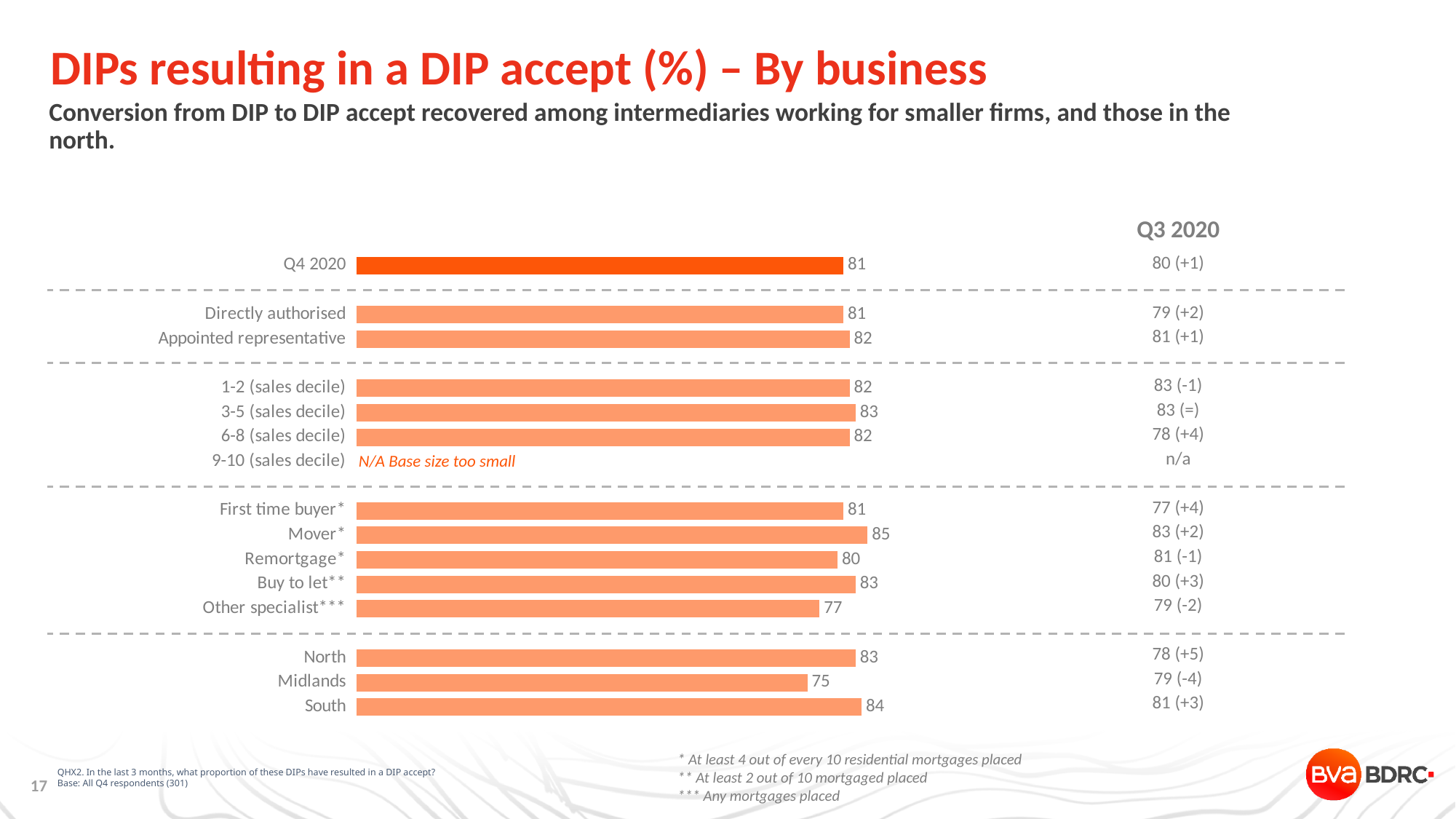
What is the value for the Q4 2020 bar at the top of the chart? 81 What is the difference between the values for Mover and Remortgage? 5 What is the value for Other specialist? 77 What is the value for Midlands? 75 Which category is marked 'N/A Base size too small' instead of a bar? 9-10 (sales decile) Which is larger, the value for North or the value for Midlands? North Which category has the highest value in the chart? Mover How many bars are plotted in the chart? 14 What is the difference between the values for South and Midlands? 9 What kind of chart is shown on the slide? Bar chart Which category has the lowest value in the chart? Midlands What is the value for Mover? 85